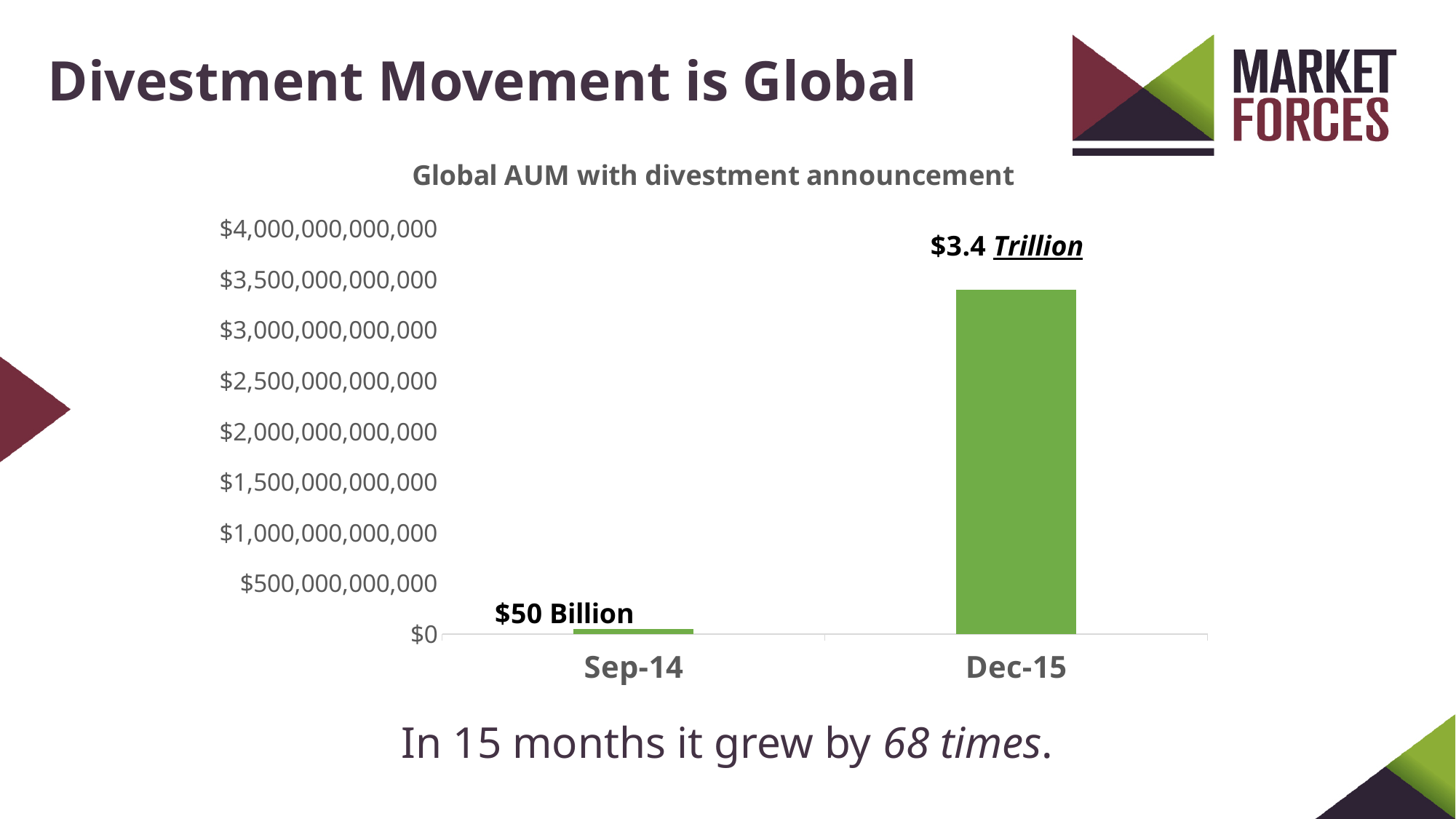
Is the value for Sep-14 greater or less than $500,000,000,000? less How many categories are shown on the x axis? 2 Which category has the highest value? Dec-15 What is the highest value shown on the y axis? $4,000,000,000,000 Do the values rise or fall from Sep-14 to Dec-15? Rise What is the value for Sep-14? $50 Billion Which category has the lowest value? Sep-14 What kind of chart is shown on the slide? Bar chart Which is larger, the value for Sep-14 or the value for Dec-15? Dec-15 What is the value for Dec-15? $3.4 Trillion Is the value for Dec-15 greater or less than $3,000,000,000,000? greater What is the title of the chart? Global AUM with divestment announcement